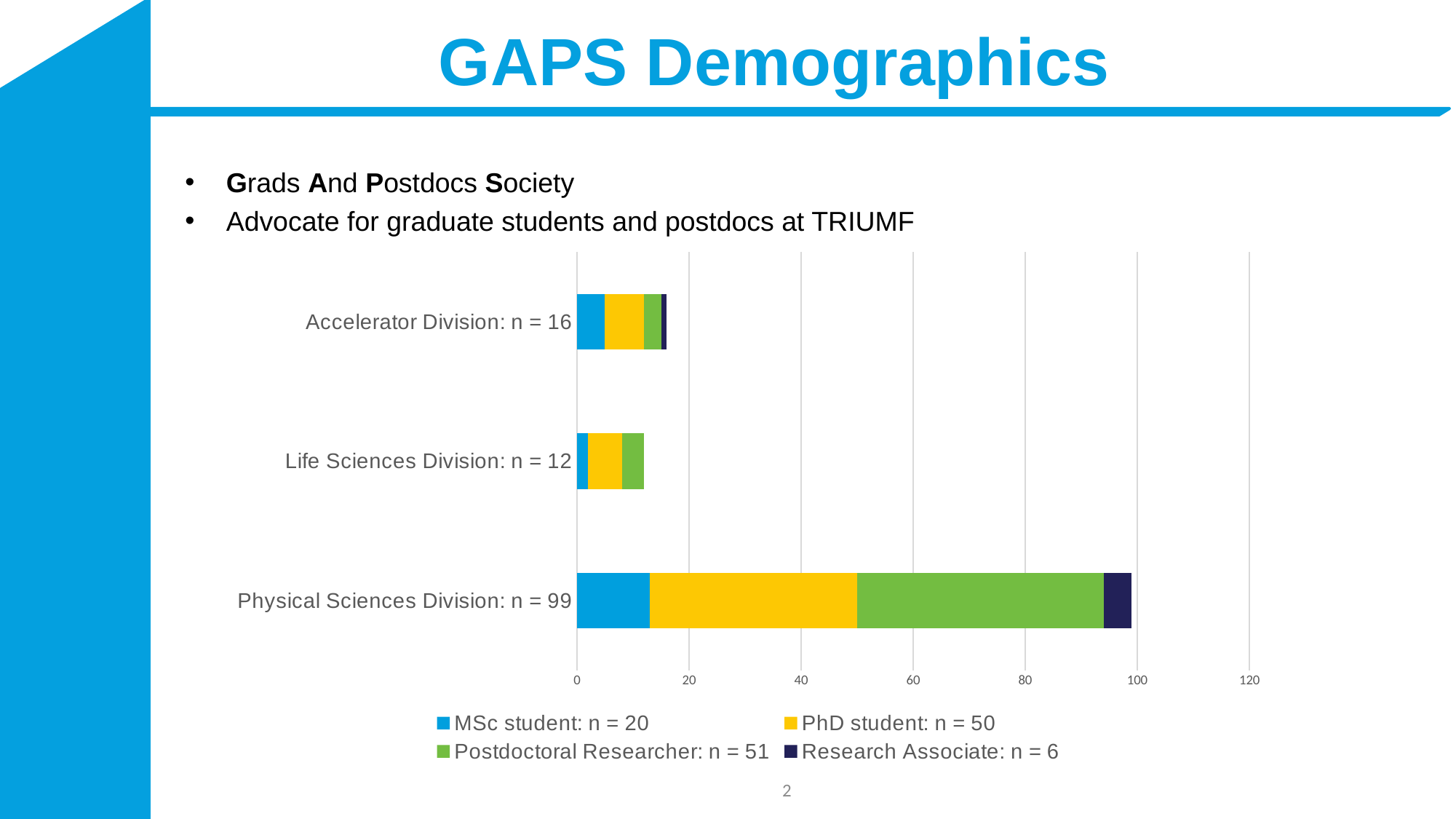
What is the total n for the Physical Sciences Division bar? 99 What is the total n for the Life Sciences Division bar? 12 How many series does the chart legend list? 4 Which division has the longest bar in the chart? Physical Sciences Division According to the legend, what is n for PhD students? 50 What is the difference between the total n for the Physical Sciences Division and the Accelerator Division? 83 Which division has the shortest bar in the chart? Life Sciences Division Is the total value for the Physical Sciences Division bar greater or less than 80? greater What kind of chart is shown on the slide? Stacked bar chart Which has a larger total n, the Accelerator Division or the Life Sciences Division? Accelerator Division Which colour represents MSc students in the chart? Blue How many divisions (categories) are plotted in the chart? 3